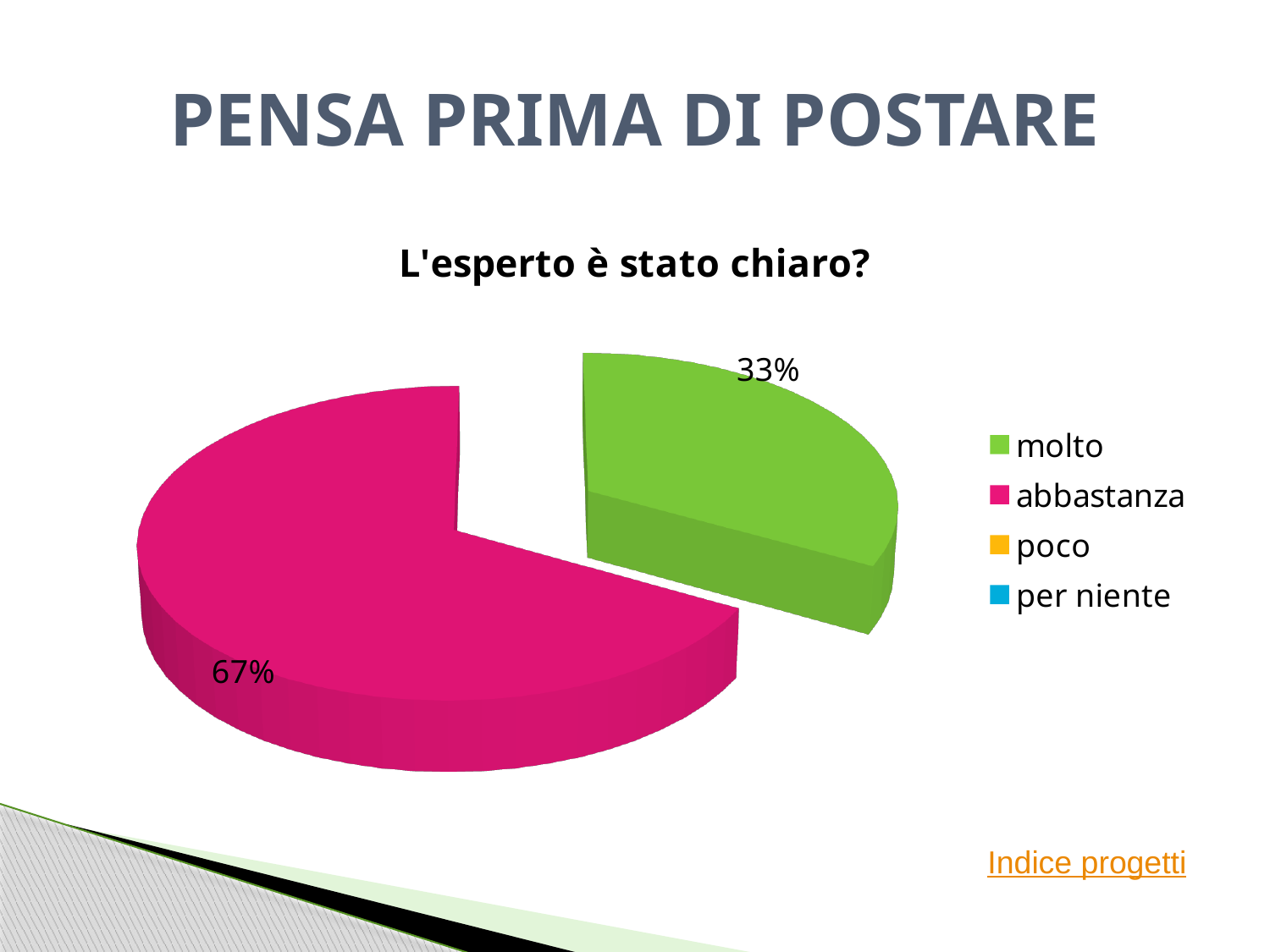
What percentage of the pie is the 'molto' slice? 33% Which colour represents 'abbastanza' in the legend? pink How many entries does the legend list? 4 How many slices are visible in the pie? 2 What is the chart's title? L'esperto è stato chiaro? What kind of chart is shown on the slide? pie chart What percentage of the pie is the 'abbastanza' slice? 67% Is the share for 'molto' greater or less than 50%? less What is the difference in percentage points between the 'abbastanza' slice and the 'molto' slice? 34 Which category has the largest slice of the pie? abbastanza Which of the two labelled slices is smaller, 'molto' or 'abbastanza'? molto